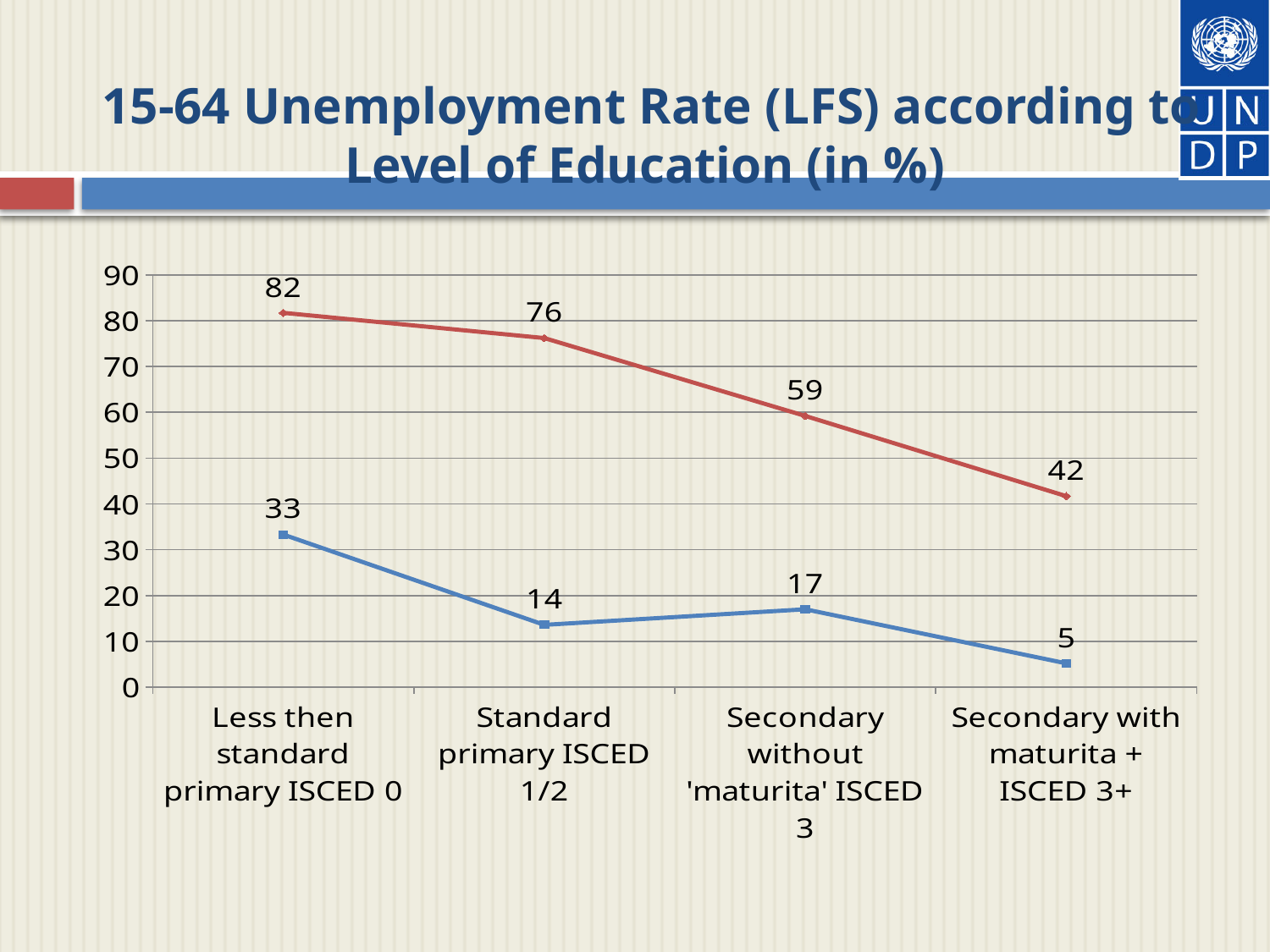
What is the value of the red line for 'Less then standard primary ISCED 0'? 82 What is the value of the blue line for 'Standard primary ISCED 1/2'? 14 Which category has the highest value on the red line? Less then standard primary ISCED 0 What is the value of the red line for 'Secondary with maturita + ISCED 3+'? 42 What is the title of the chart on the slide? 15-64 Unemployment Rate (LFS) according to Level of Education (in %) Which category has the lowest value on the blue line? Secondary with maturita + ISCED 3+ Which is larger for 'Standard primary ISCED 1/2': the red line value or the blue line value? the red line value What is the value of the blue line for 'Secondary without 'maturita' ISCED 3'? 17 Does the red line rise or fall from left to right across the education levels? fall What type of chart is shown on the slide? line chart How many education-level categories are shown on the x axis? 4 What is the difference between the red line and the blue line for 'Secondary without 'maturita' ISCED 3'? 42